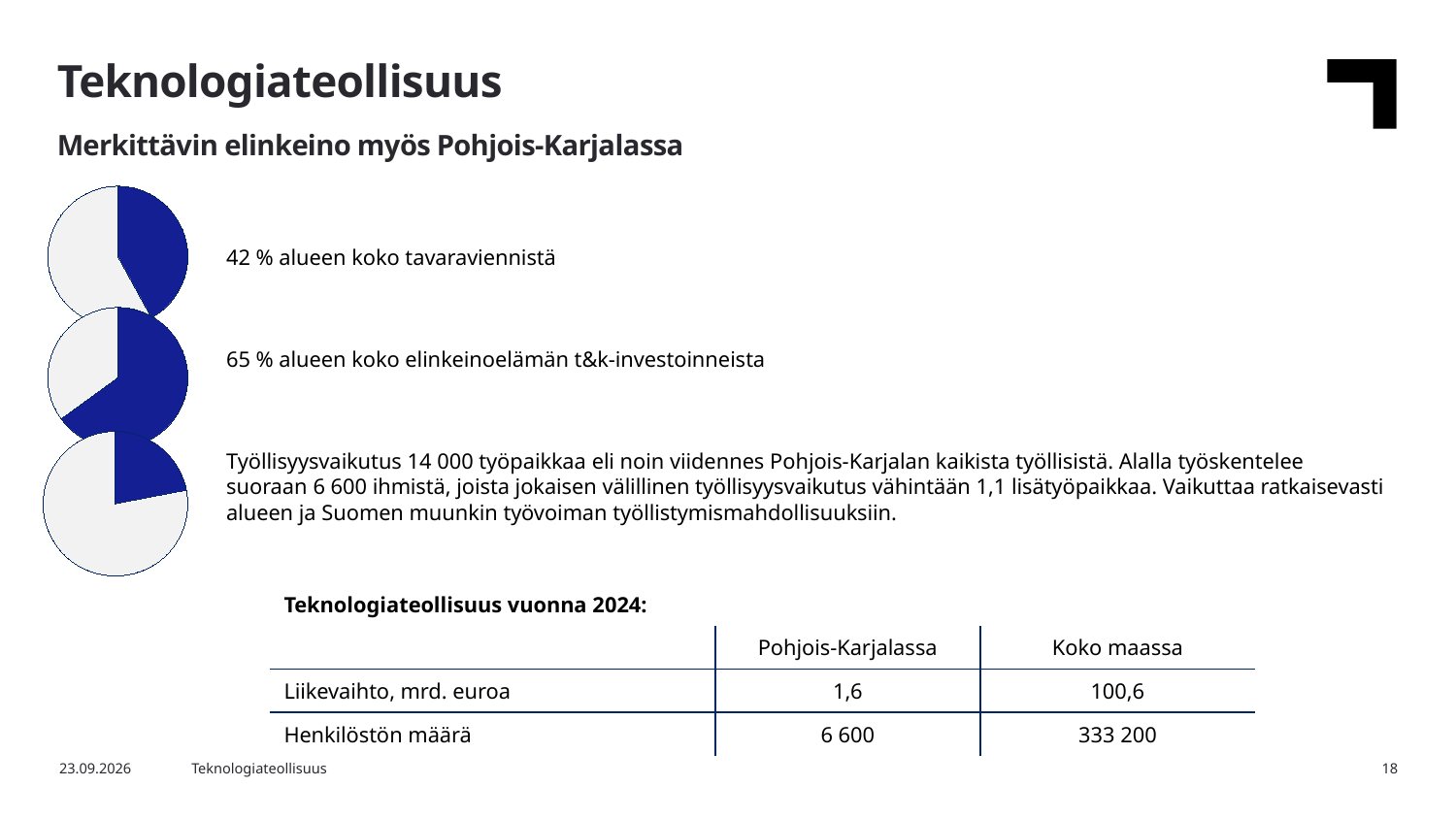
What is the difference in percentage points between the shares shown by the middle and top pie charts? 23 percentage points What colour is used for the highlighted slices in the pie charts? Dark blue In the middle pie chart, what share of the region's business R&D investments does the highlighted slice represent? 65 % What kind of charts are shown on the left side of the slide? Pie charts Which of the three pie charts has the largest highlighted slice? The middle one (65 % of R&D investments) Which of the three pie charts has the smallest highlighted slice? The bottom one (employment impact) What is the title of the slide containing the pie charts? Teknologiateollisuus Is the highlighted slice in the top pie chart (goods exports) larger or smaller than the one in the middle pie chart (R&D investments)? Smaller Does the highlighted slice in the middle pie chart represent more or less than half of the pie? More How many pie charts are on the slide? 3 Is the highlighted slice in the bottom pie chart larger or smaller than the one in the top pie chart? Smaller In the top pie chart, what share of the region's total goods exports does the highlighted slice represent? 42 %